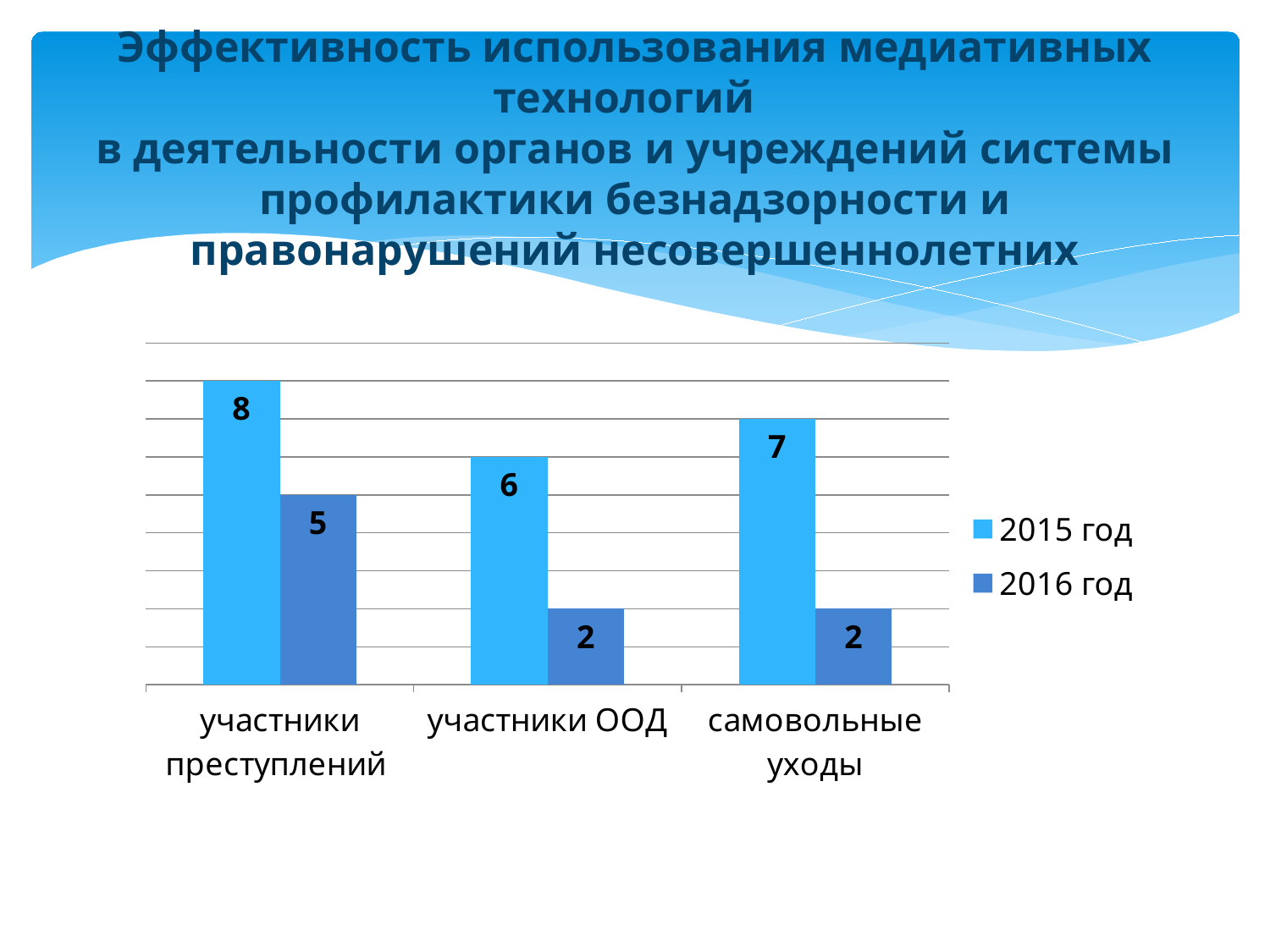
How many categories are shown on the x axis? 3 What is the value for 2016 год in the участники преступлений category? 5 What is the value for 2015 год in the участники преступлений category? 8 Which category has the highest value for 2015 год? участники преступлений What is the value for 2016 год in the участники ООД category? 2 Which category has the highest value for 2016 год? участники преступлений What kind of chart is shown on the slide? bar chart What is the difference between the 2015 год and 2016 год values for самовольные уходы? 5 Which is larger: the 2015 год value for участники ООД or the 2015 год value for самовольные уходы? самовольные уходы What is the value for 2015 год in the самовольные уходы category? 7 How many series does the legend list? 2 What is the difference between the 2015 год and 2016 год values for участники ООД? 4